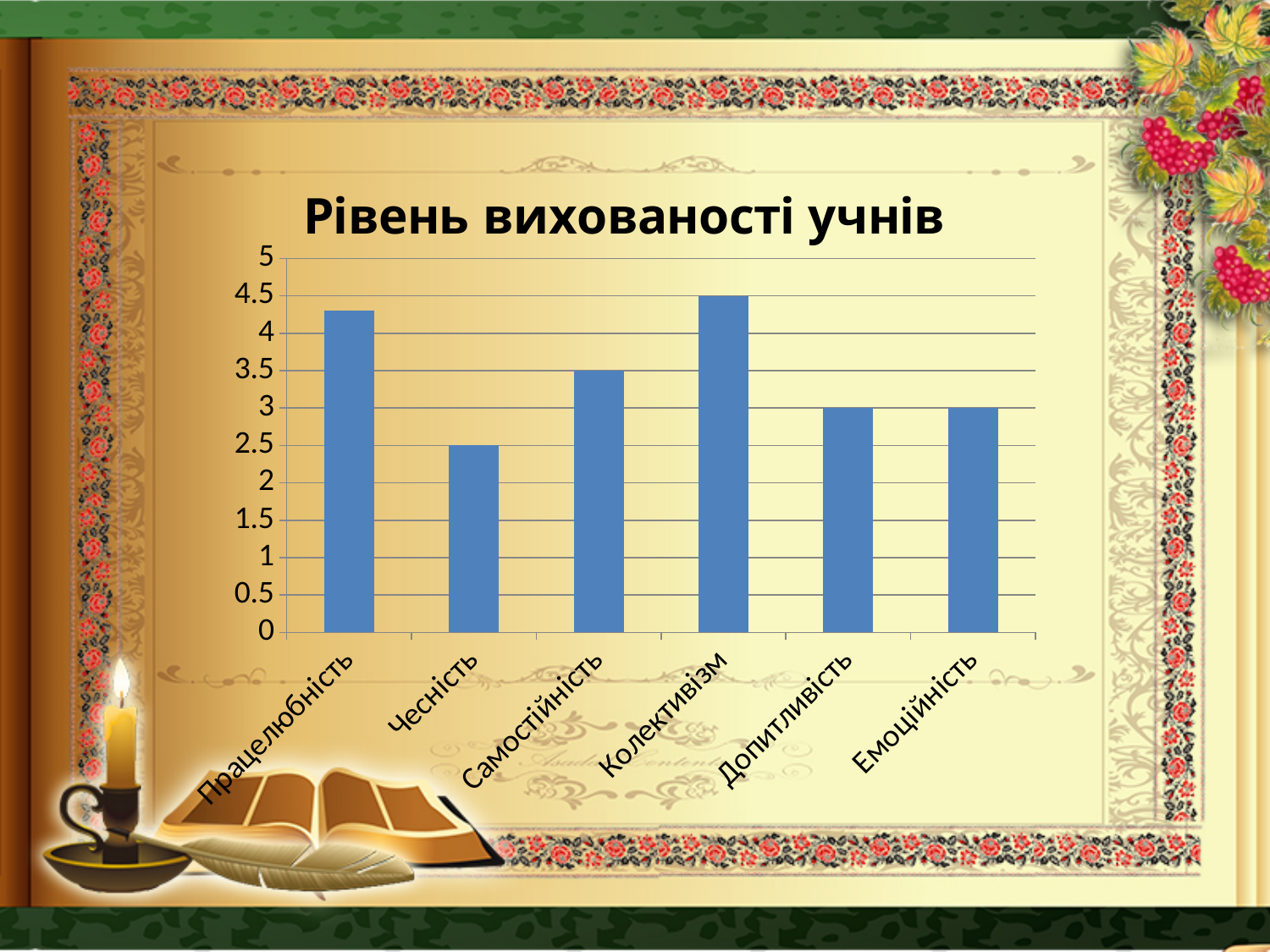
What is the value for Допитливість? 3 Is the value for Працелюбність greater or less than 4? greater What is the difference between the values for Колективізм and Чесність? 2 What is the value for Колективізм? 4.5 What is the value for Самостійність? 3.5 What is the title of the chart? Рівень вихованості учнів Which category has the highest value in the chart? Колективізм How many categories are shown on the x axis of the chart? 6 What is the value for Чесність? 2.5 Which is larger, the value for Самостійність or the value for Емоційність? Самостійність What kind of chart is shown on the slide? bar chart Which category has the lowest value in the chart? Чесність